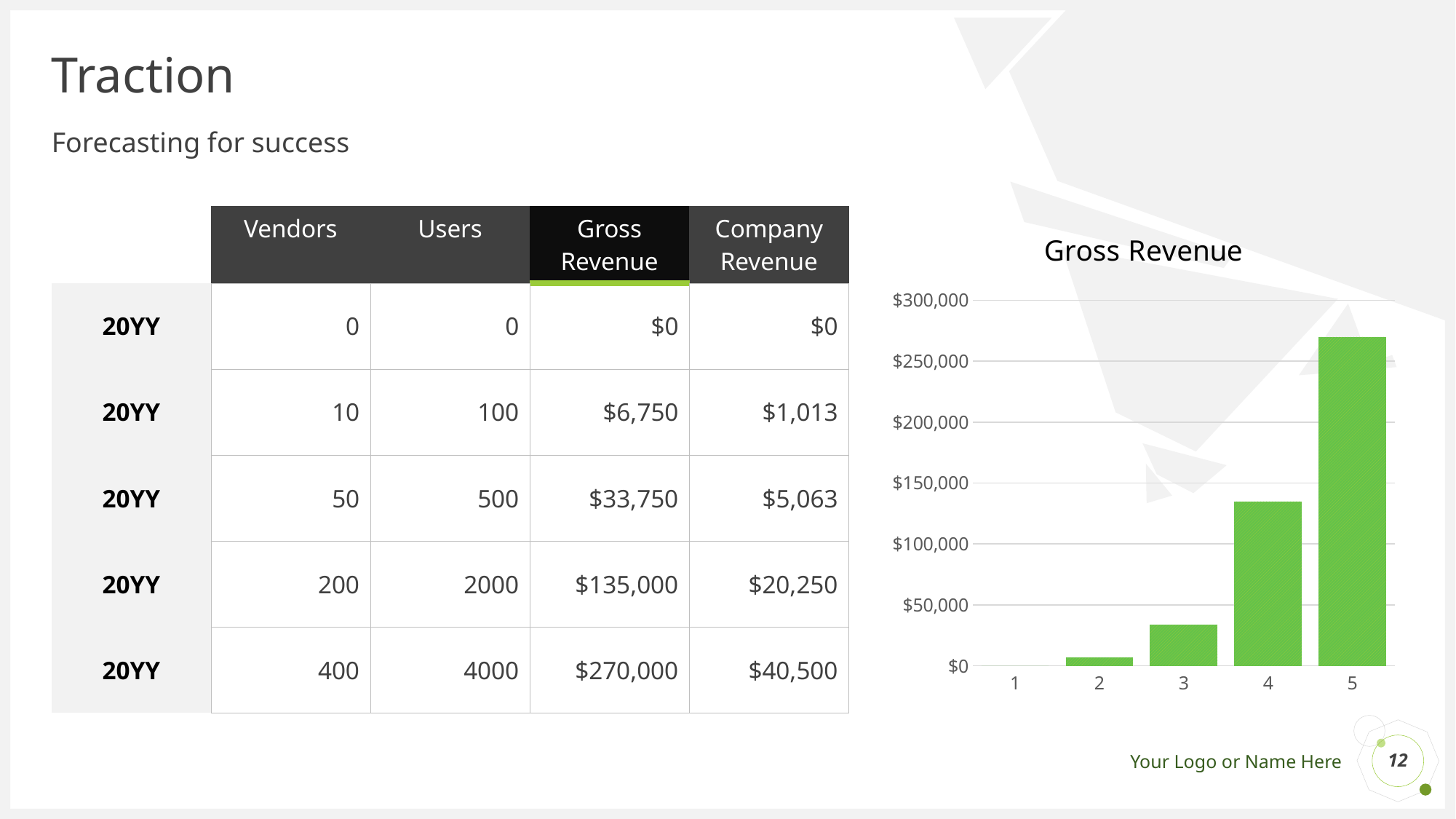
Which category has the lowest bar in the Gross Revenue chart? 1 Is the value for category 4 greater or less than $100,000? greater What type of chart is shown on the slide? bar chart Which category has the highest bar in the Gross Revenue chart? 5 Do the values in the Gross Revenue chart rise or fall from category 1 to category 5? rise What is the highest value shown on the vertical axis of the chart? $300,000 Is the value for category 5 greater or less than $250,000? greater How many bars (categories) are plotted in the Gross Revenue chart? 5 Which is larger in the Gross Revenue chart, the value for category 4 or category 5? 5 What is the title of the chart? Gross Revenue Is the value for category 3 greater or less than $50,000? less